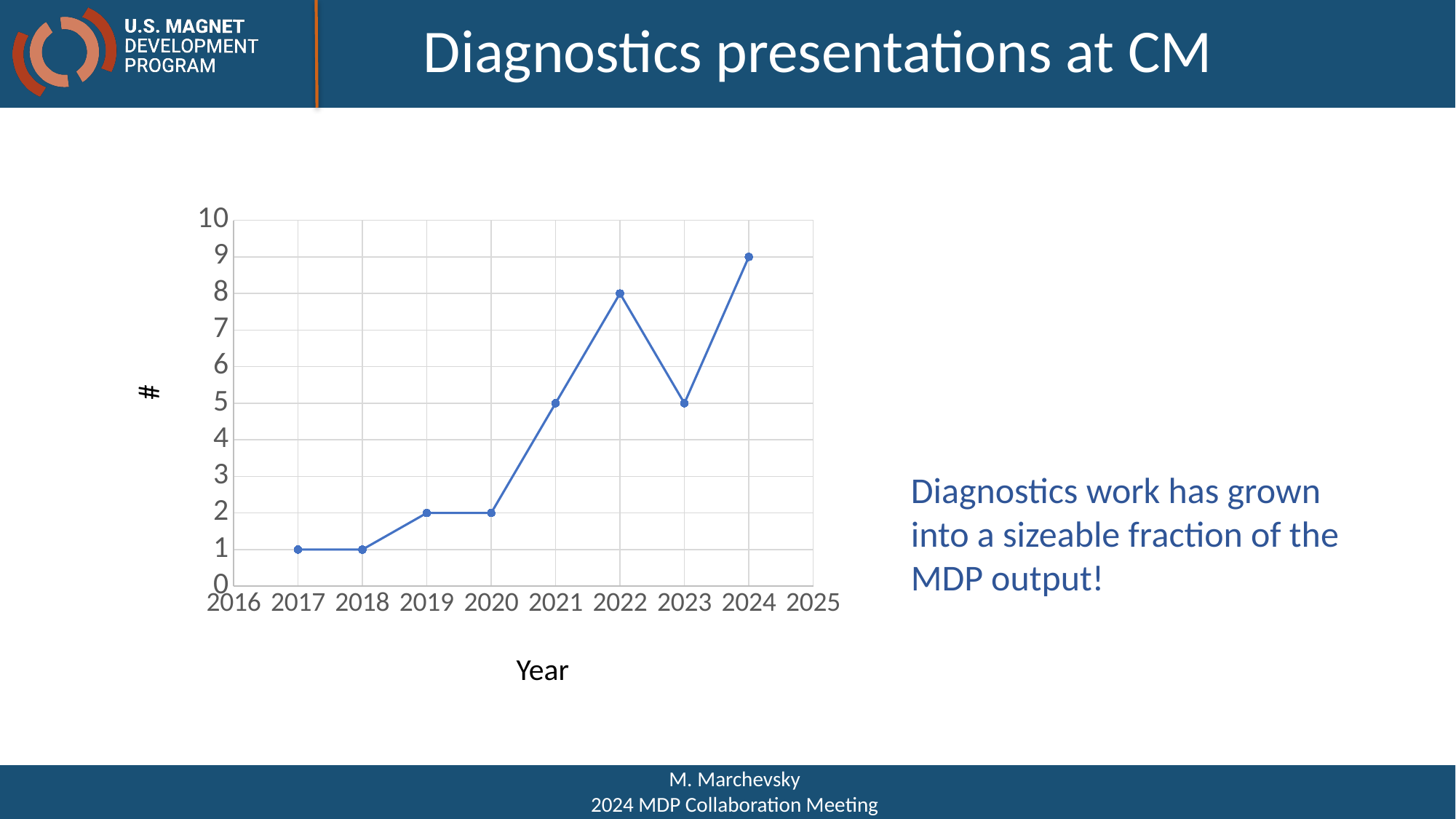
Which year has the highest number of diagnostics presentations? 2024 What is the number of diagnostics presentations in 2023? 5 Which year has more diagnostics presentations, 2021 or 2023? They are equal (5 each) What is the number of diagnostics presentations in 2022? 8 How many data points are plotted on the line chart? 8 Is the value for 2021 greater or less than 4? greater Overall, do the values rise or fall from 2017 to 2024? rise What is the label of the x axis? Year What kind of chart is shown on the slide? line chart What is the number of diagnostics presentations in 2024? 9 What is the number of diagnostics presentations in 2017? 1 What is the difference between the number of presentations in 2022 and in 2023? 3